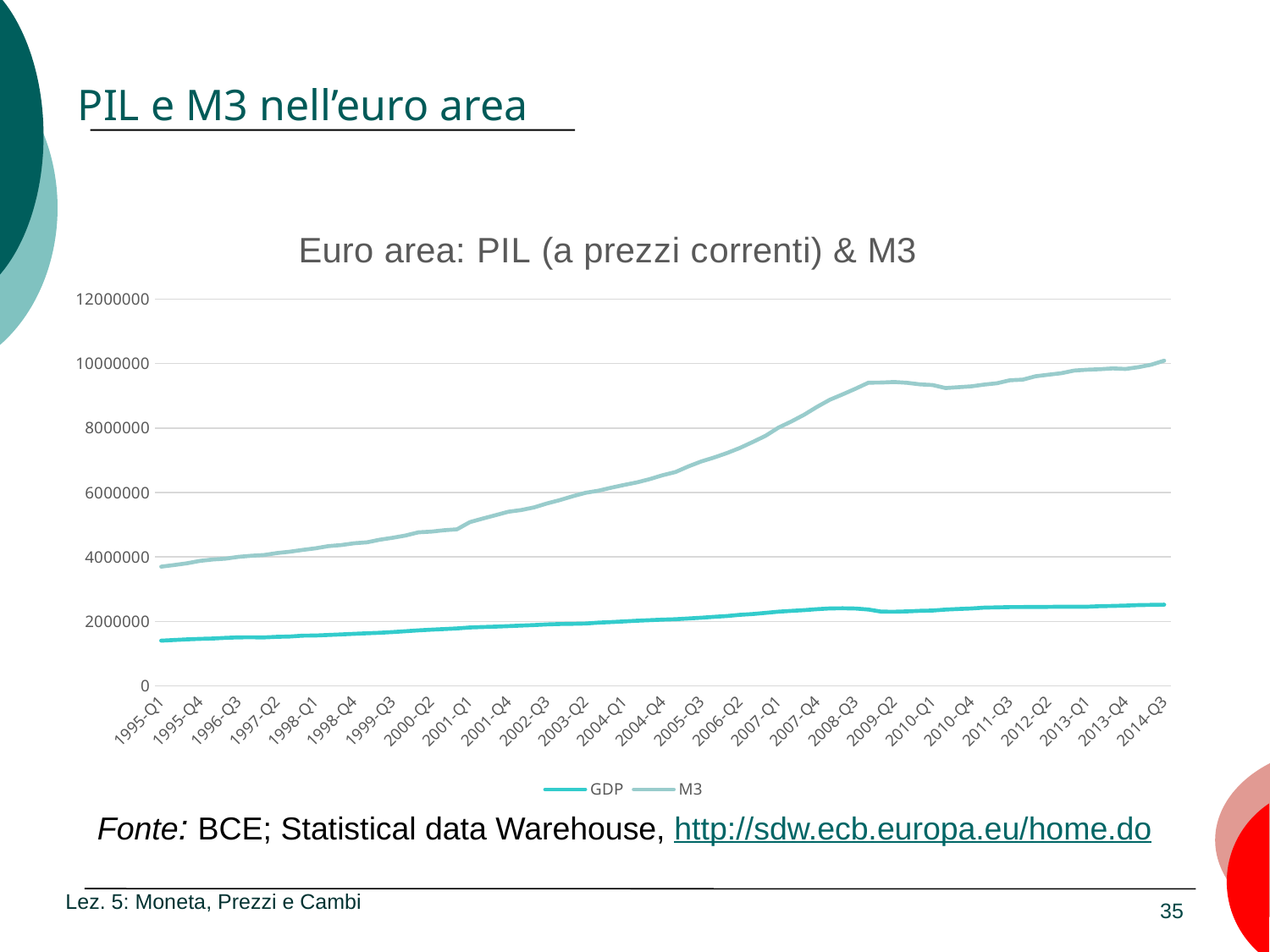
What is the title of the chart? Euro area: PIL (a prezzi correnti) & M3 At which quarter is the M3 series at its lowest? 1995-Q1 Does the M3 series generally rise or fall from 1995-Q1 to 2014-Q3? rise Which series is higher at 2014-Q3, GDP or M3? M3 Does the GDP series generally rise or fall from 1995-Q1 to 2014-Q3? rise Which two series are listed in the legend? GDP and M3 What kind of chart is shown on the slide? line chart Is the value of M3 at 1995-Q1 greater or less than 4000000? less Is the value of GDP at 1995-Q1 greater or less than 2000000? less How many series does the legend list? 2 Is the value of M3 at 2008-Q3 greater or less than 8000000? greater At which quarter is the M3 series at its highest? 2014-Q3